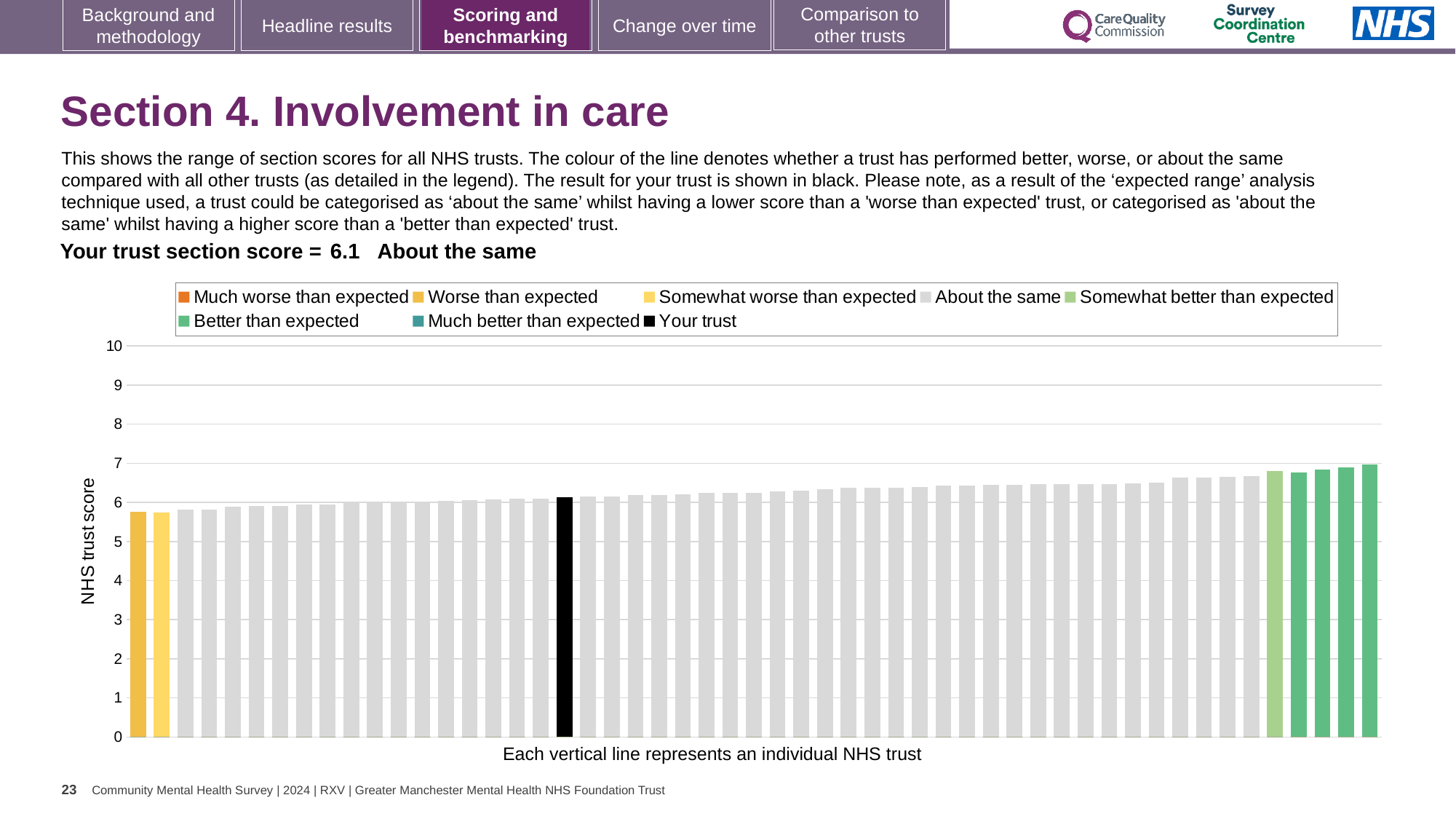
Which performance category is your trust placed in for Section 4? About the same What colour is used for the bar representing your trust? black What is the section score for your trust shown on the slide? 6.1 What is the label on the vertical axis of the chart? NHS trust score What kind of chart is shown on the slide? bar chart Is the value of the highest bar in the chart greater or less than 8? less Is the value of the leftmost bar greater or less than 6? less How many entries does the chart legend list? 8 Is the value of the lowest bar in the chart greater or less than 5? greater Do the bar values rise or fall from left to right along the x axis? rise How many bars in the chart are coloured yellow? 2